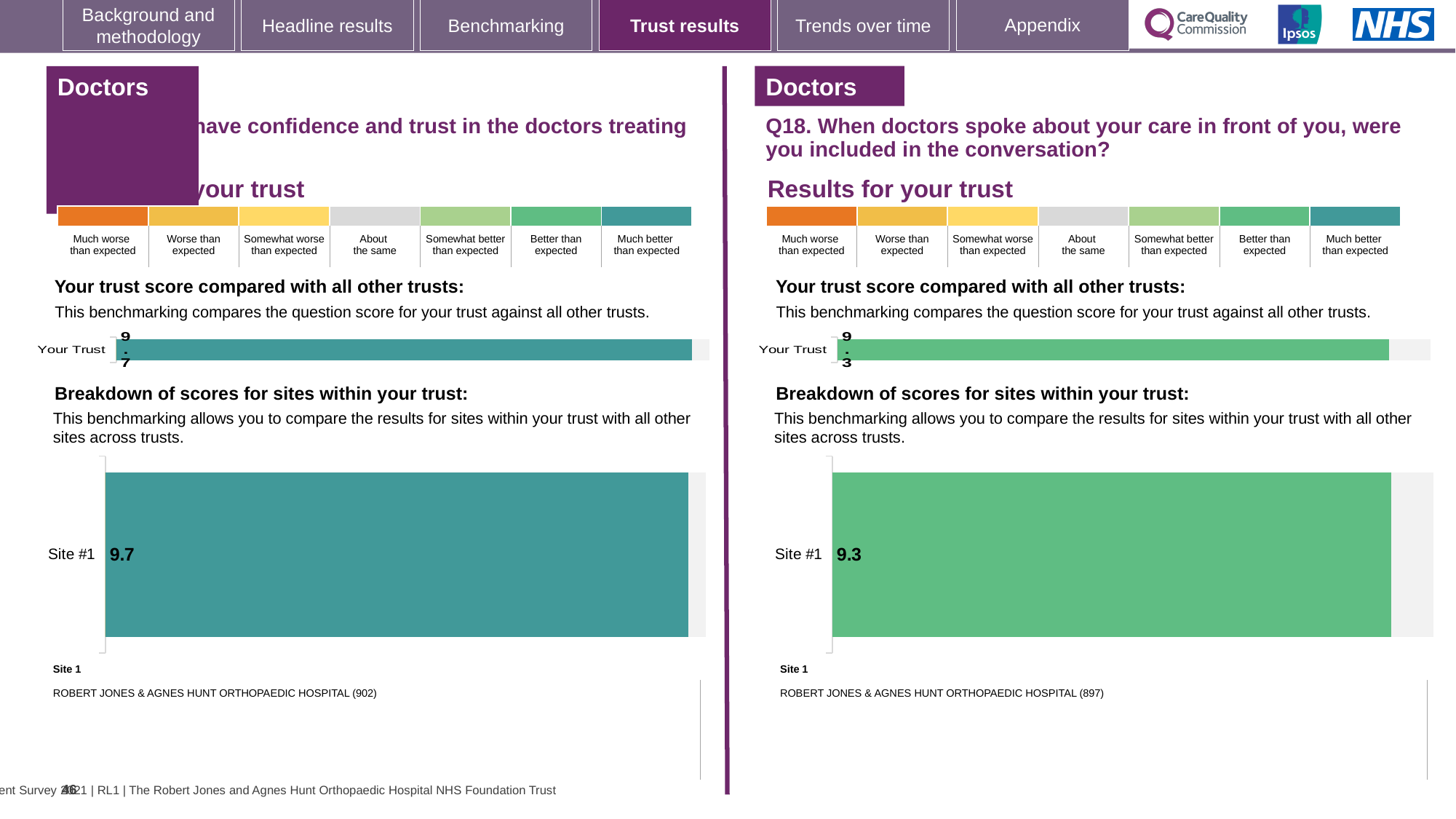
What type of chart is used to show the Your Trust score on the left-hand slide? Bar chart In the left-hand 'Breakdown of scores for sites within your trust' chart, what is the score for Site #1? 9.7 How many rating categories are shown in the colour scale above the 'Your trust score compared with all other trusts' chart on the Q18 slide? 7 Which Site #1 score is larger: the one in the left-hand breakdown chart or the one in the Q18 breakdown chart? The left-hand chart (9.7) How many sites are shown in the Q18 'Breakdown of scores for sites within your trust' chart? 1 What type of chart is used in the Q18 'Breakdown of scores for sites within your trust' section? Bar chart Is the Your Trust score in the Q18 chart greater or less than the Your Trust score in the left-hand chart? less On the left-hand slide, what is the score shown for Your Trust in the 'Your trust score compared with all other trusts' chart? 9.7 What is the difference between the Site #1 score in the left-hand breakdown chart and the Site #1 score in the Q18 breakdown chart? 0.4 On the Q18 (right-hand) slide, what is the score shown for Your Trust in the 'Your trust score compared with all other trusts' chart? 9.3 In the Q18 'Breakdown of scores for sites within your trust' chart, what is the score for Site #1? 9.3 Which hospital is listed as Site 1 beneath the Q18 breakdown chart? ROBERT JONES & AGNES HUNT ORTHOPAEDIC HOSPITAL (897)